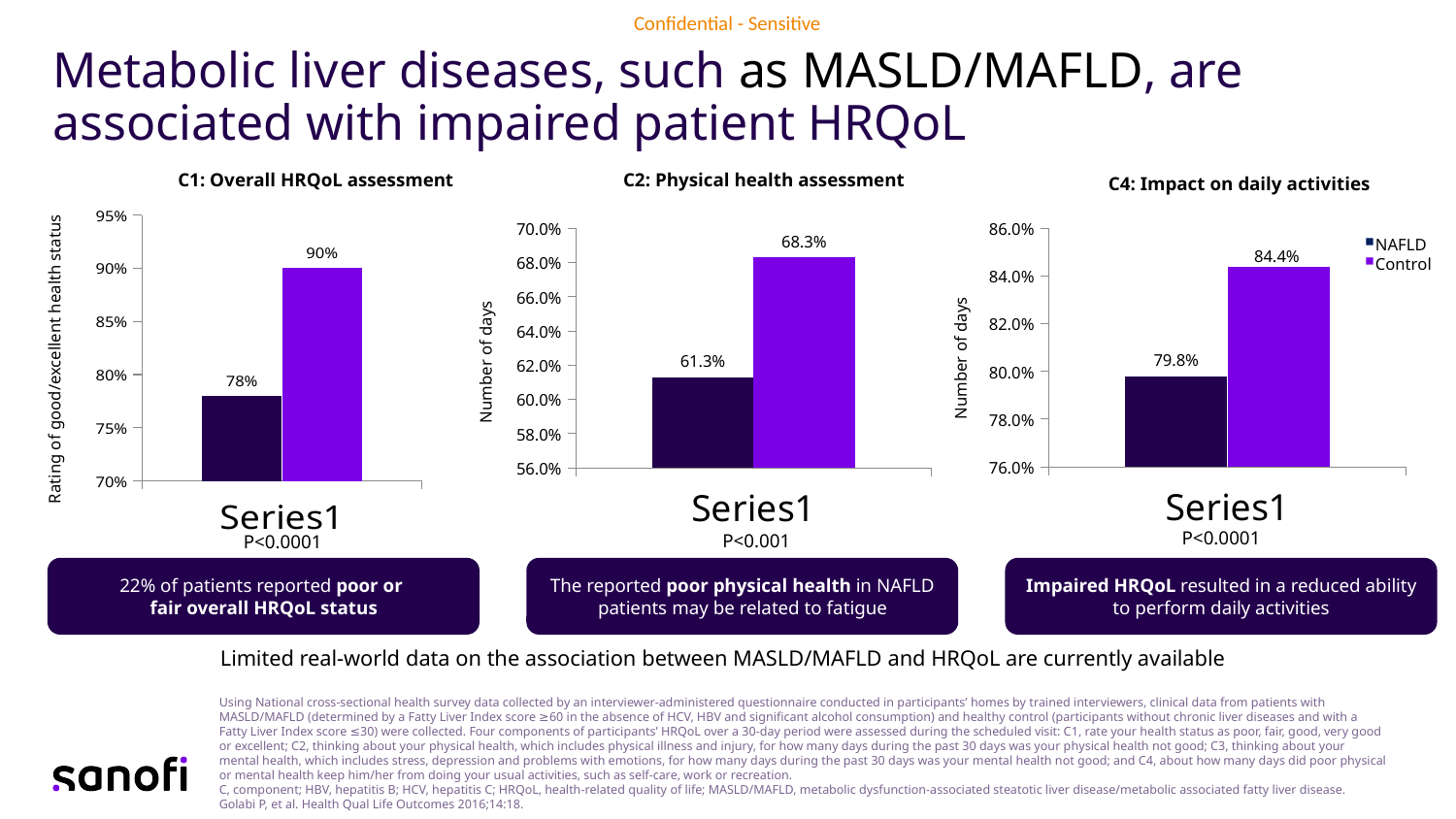
In the 'C4: Impact on daily activities' chart, what is the value for NAFLD? 79.8% In the 'C2: Physical health assessment' chart, what is the value for Control? 68.3% In the 'C2: Physical health assessment' chart, which is larger, the NAFLD value or the Control value? Control What kind of chart is 'C2: Physical health assessment'? Bar chart In the 'C1: Overall HRQoL assessment' chart, what is the value for NAFLD? 78% In the 'C2: Physical health assessment' chart, what is the value for NAFLD? 61.3% In the 'C1: Overall HRQoL assessment' chart, what is the difference between the Control and NAFLD values? 12% In the 'C1: Overall HRQoL assessment' chart, what is the value for Control? 90% In the 'C4: Impact on daily activities' chart, what is the value for Control? 84.4% How many series does the legend on the 'C4: Impact on daily activities' chart list? 2 What is the y-axis label of the 'C1: Overall HRQoL assessment' chart? Rating of good/excellent health status In the 'C4: Impact on daily activities' chart, which series has the lowest value? NAFLD